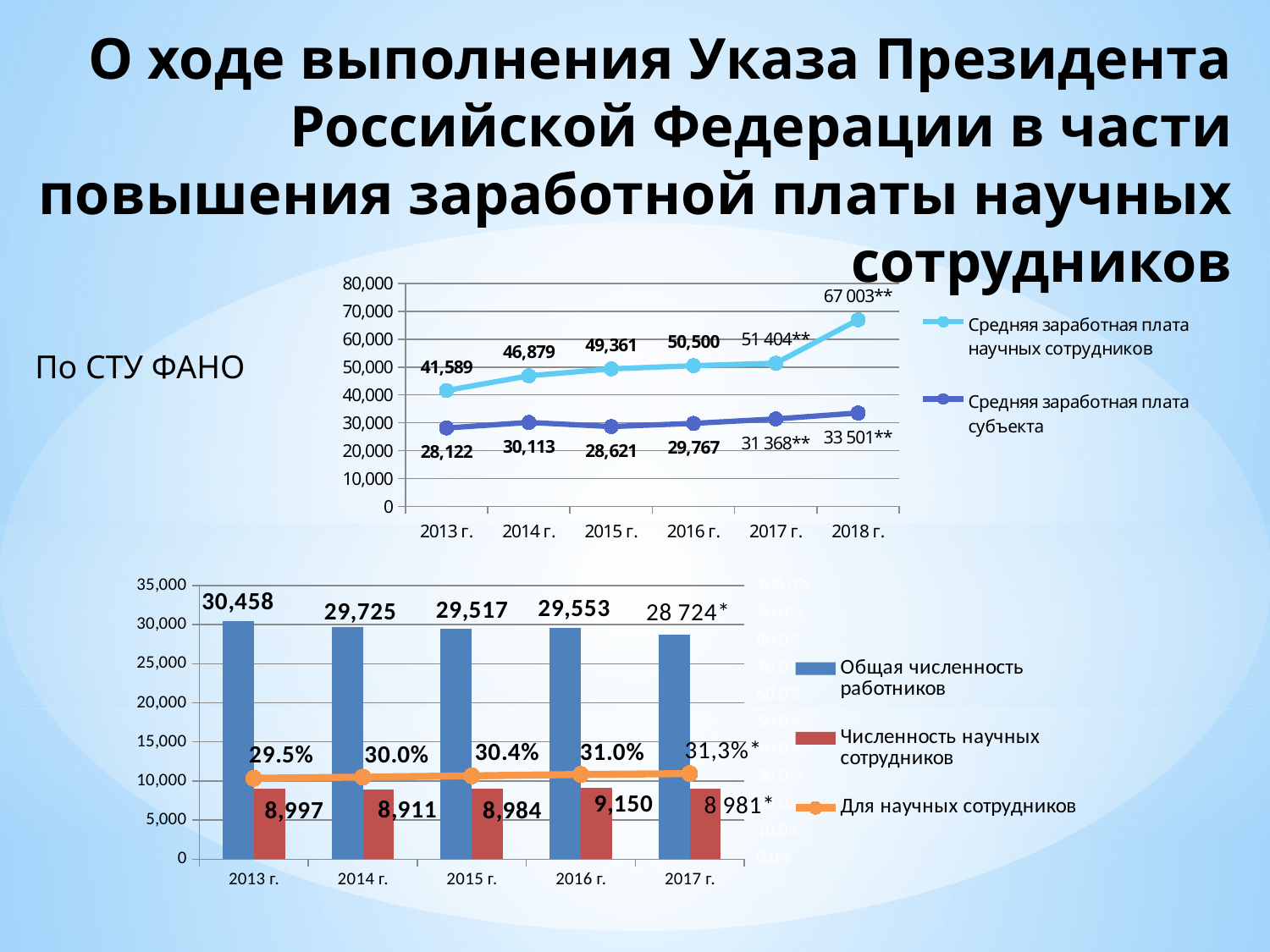
In the top chart, what is the value of Средняя заработная плата субъекта for 2016 г.? 29,767 In the bottom chart, what is the value of Численность научных сотрудников for 2016 г.? 9,150 In the bottom chart, what is the value of Общая численность работников for 2013 г.? 30,458 In the bottom chart, which year has the highest value for Численность научных сотрудников? 2016 г. In the top chart, which year has the lowest value for Средняя заработная плата субъекта? 2013 г. In the top chart, how many series does the legend list? 2 In the bottom chart, what is the value of Для научных сотрудников for 2015 г.? 30.4% In the bottom chart, how many years are shown on the x axis? 5 In the top chart, what is the difference between Средняя заработная плата научных сотрудников and Средняя заработная плата субъекта in 2015 г.? 20,740 In the top chart, does Средняя заработная плата научных сотрудников rise or fall from 2013 г. to 2018 г.? rise In the top chart, what is the value of Средняя заработная плата научных сотрудников for 2013 г.? 41,589 In the top chart, which year has the highest value for Средняя заработная плата научных сотрудников? 2018 г.